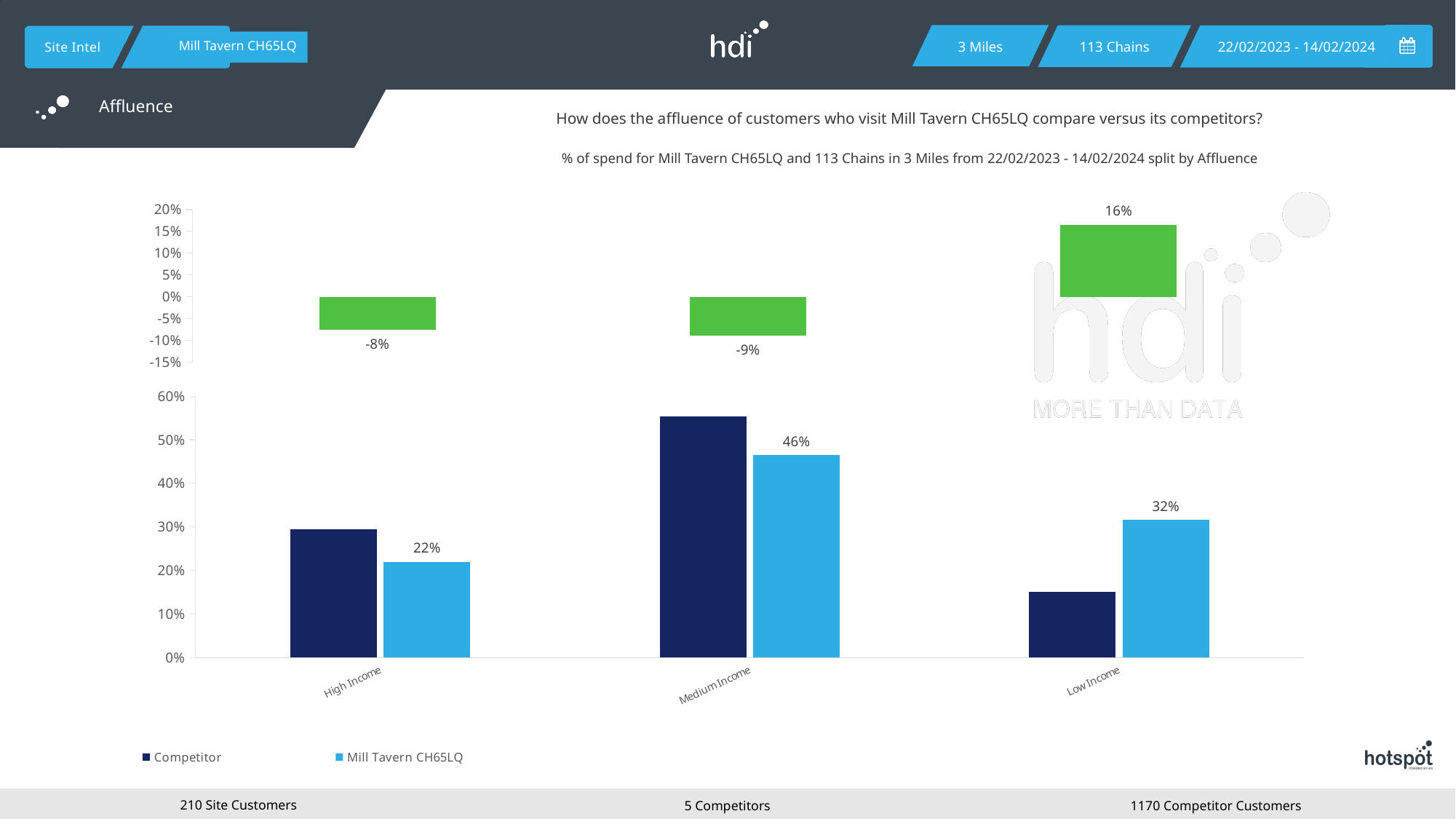
How many series does the legend of the bottom chart list? 2 In the bottom chart, what is the difference between the Mill Tavern CH65LQ values for Medium Income and High Income? 24% In the bottom chart, is the Competitor value for Medium Income greater or less than 50%? greater In the top chart, which category has the lowest value? Medium Income In the bottom chart, which is larger for Low Income: Competitor or Mill Tavern CH65LQ? Mill Tavern CH65LQ In the bottom chart, is the Competitor value for Low Income greater or less than 20%? less In the top chart, what is the value shown for the High Income category? -8% In the bottom chart, what is the value for Mill Tavern CH65LQ in the High Income category? 22% In the bottom chart, which category has the highest value for Mill Tavern CH65LQ? Medium Income In the bottom chart, what is the value for Mill Tavern CH65LQ in the Low Income category? 32% In the bottom chart, what is the value for Mill Tavern CH65LQ in the Medium Income category? 46% In the top chart, what is the value shown for the Low Income category? 16%